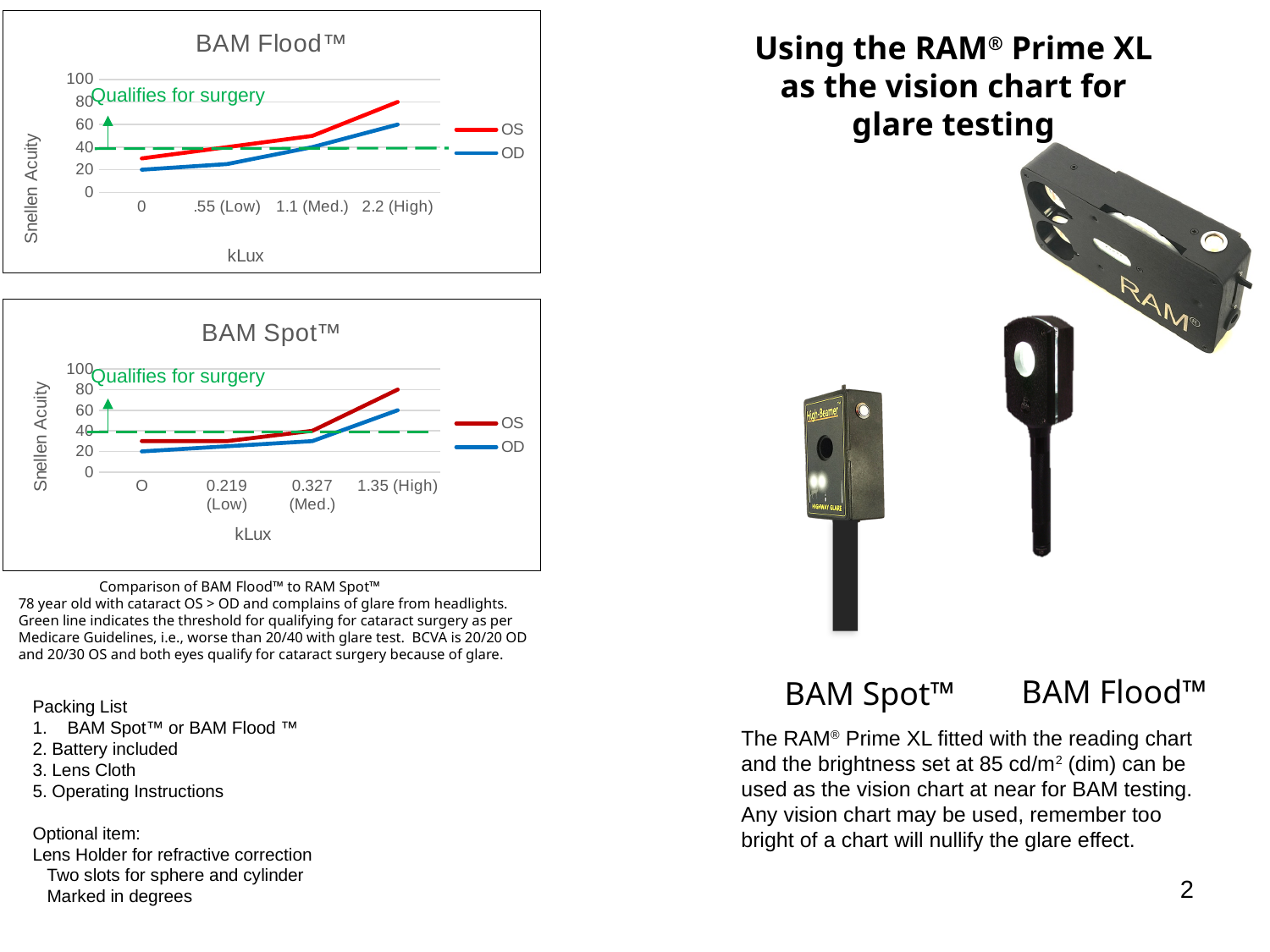
In the BAM Spot™ chart, do the OS values rise or fall from O to 1.35 (High)? rise How many categories are on the x axis of the BAM Flood™ chart? 4 What kind of chart is the BAM Flood™ chart? line chart In the BAM Spot™ chart, is the OS value at O greater or less than 40? less What is the x-axis title of the BAM Spot™ chart? kLux In the BAM Flood™ chart, which series has the higher value at 2.2 (High), OS or OD? OS In the BAM Flood™ chart, is the OD value at 0 greater or less than 40? less In the BAM Spot™ chart, is the OD value at 1.35 (High) greater or less than 40? greater How many series does the legend of the BAM Spot™ chart list? 2 In the BAM Flood™ chart, at which x-axis category is the OD series highest? 2.2 (High) What label is attached to the green dashed line in the BAM Flood™ chart? Qualifies for surgery